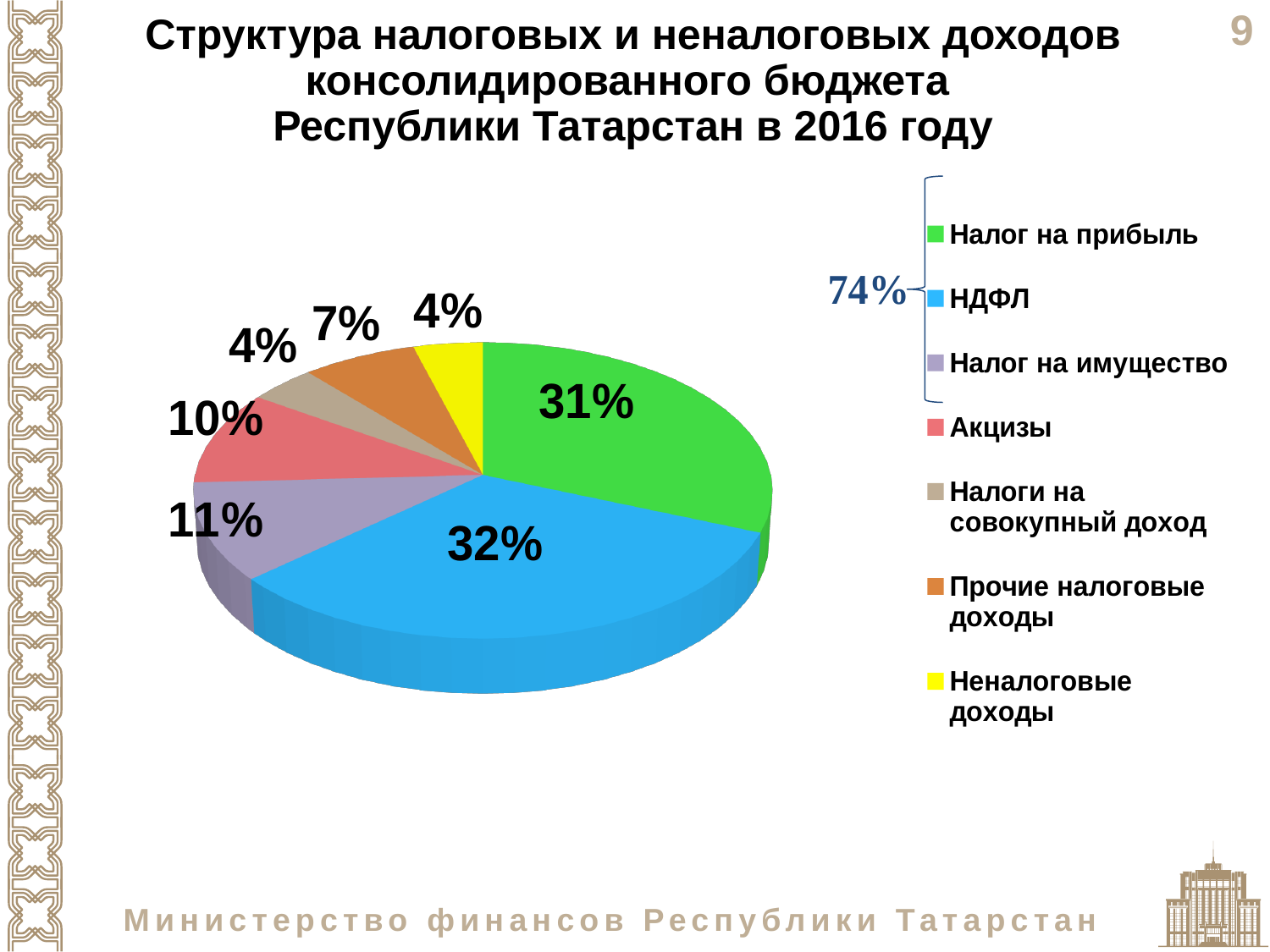
Which colour represents Неналоговые доходы in the legend? yellow What combined share is indicated by the bracket next to the legend for Налог на прибыль, НДФЛ and Налог на имущество? 74% What is the value shown for Налог на имущество? 11% What is the value shown for Прочие налоговые доходы? 7% What kind of chart is shown on the slide? pie chart What is the difference between the shares of НДФЛ and Налог на прибыль? 1% Which category has the largest share of the pie? НДФЛ What is the value shown for Налог на прибыль? 31% How many slices does the pie chart have? 7 What is the value shown for Акцизы? 10% Which is larger, the share of Акцизы or the share of Прочие налоговые доходы? Акцизы What share of the pie does НДФЛ account for? 32%